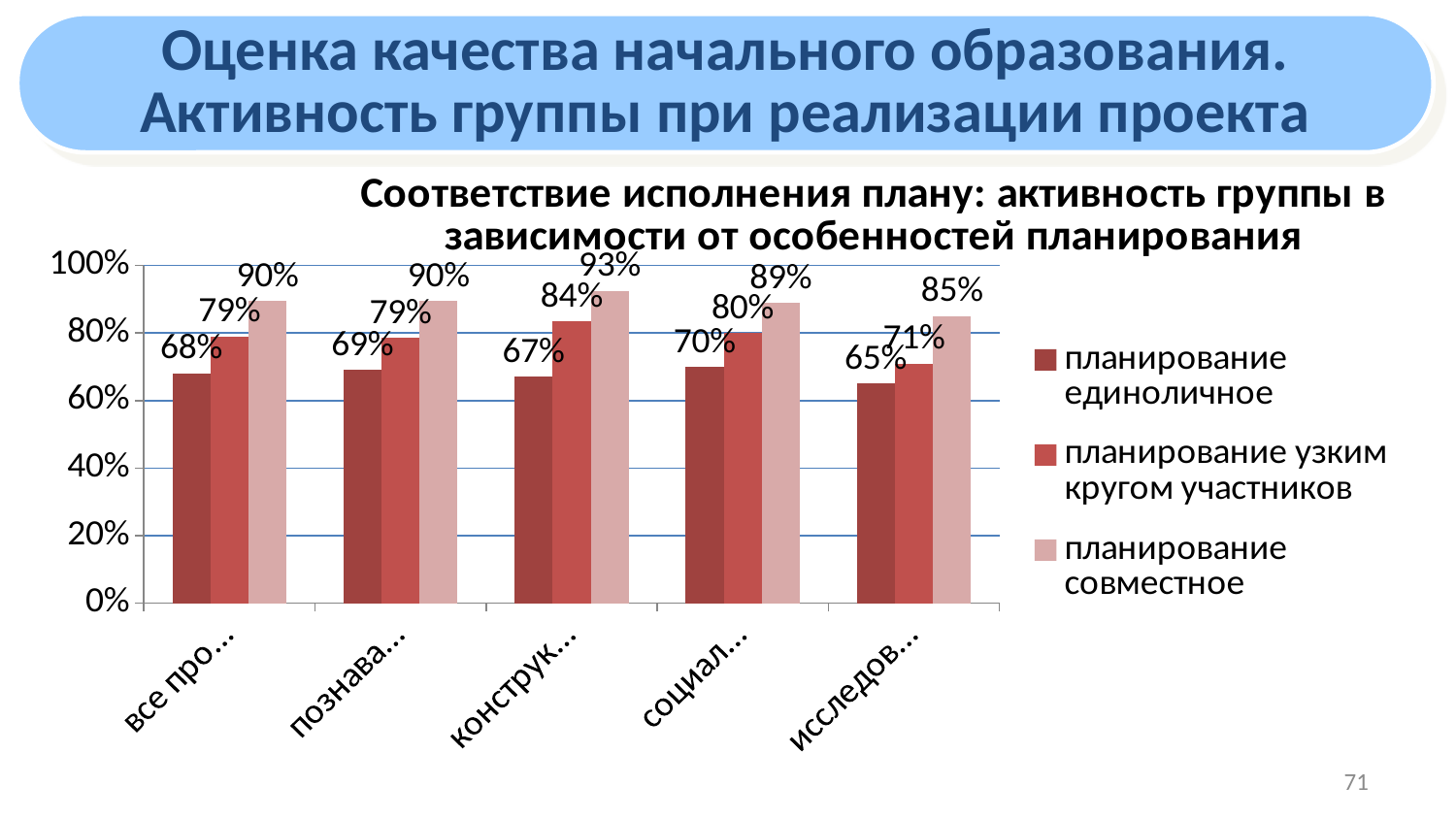
How many categories are shown along the x axis? 5 Which category has the highest value for "планирование совместное"? the third category (конструк...) Which is larger: "планирование единоличное" for the fourth category (социал...) or for the fifth category (исследов...)? the fourth category (социал...) What is the title of the chart? Соответствие исполнения плану: активность группы в зависимости от особенностей планирования What is the value of "планирование узким кругом участников" for the fifth category (исследов...)? 71% What is the value of "планирование единоличное" for the second category (познава...)? 69% For the third category (конструк...), what is the difference between "планирование совместное" and "планирование единоличное"? 26 percentage points What kind of chart is shown on the slide? bar chart Is the value of "планирование единоличное" for the first category (все про...) greater or less than 80%? less How many series does the legend list? 3 What is the value of "планирование совместное" for the third category (конструк...)? 93% Which category has the lowest value for "планирование единоличное"? the fifth category (исследов...)